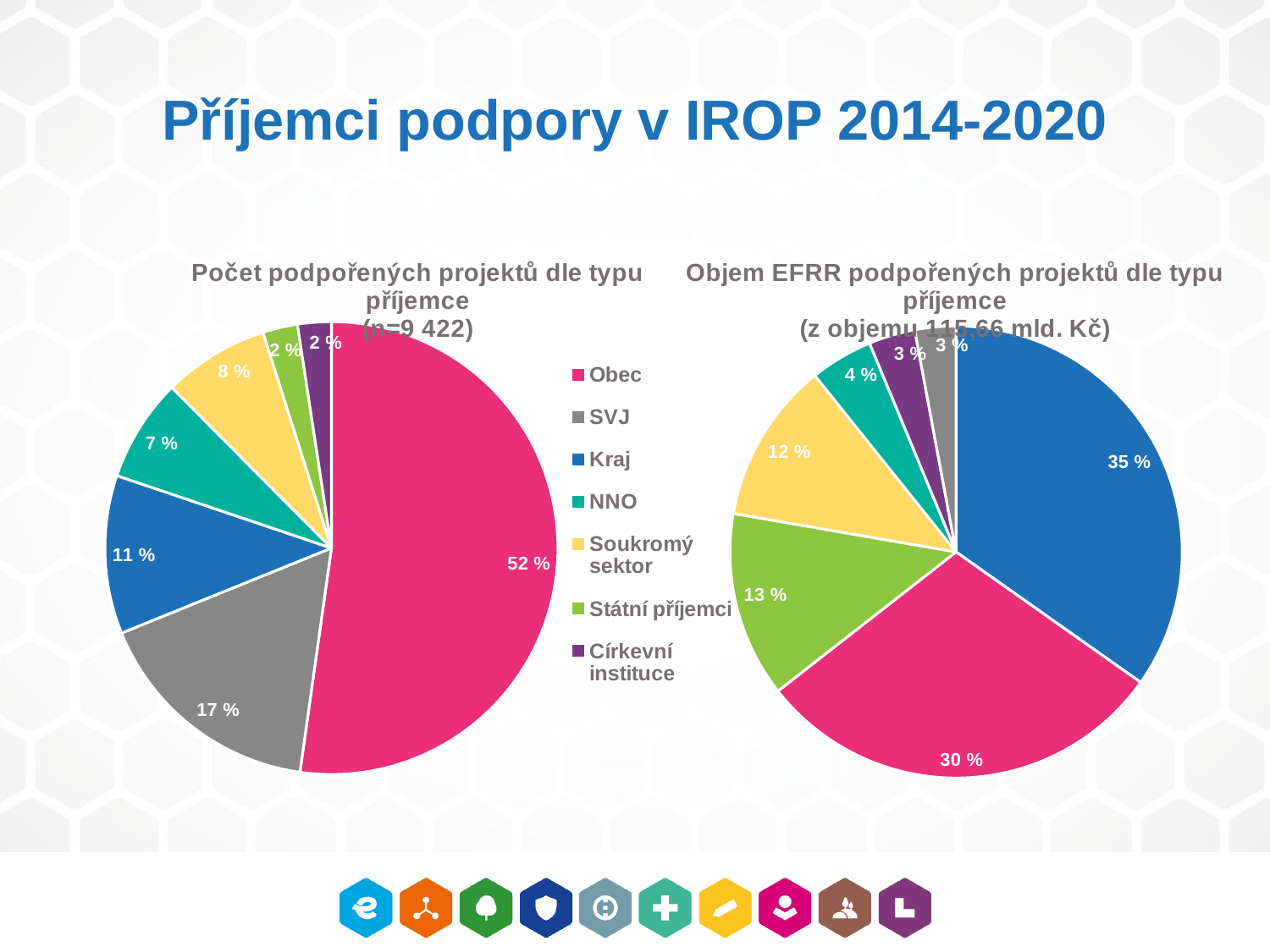
In the left pie chart (Počet podpořených projektů dle typu příjemce), what is the difference between the shares of Obec and SVJ? 35 % In the right pie chart (Objem EFRR podpořených projektů dle typu příjemce), what is the difference between the shares of Kraj and Obec? 5 % In the right pie chart (Objem EFRR podpořených projektů dle typu příjemce), what share is shown for Státní příjemci? 13 % In the right pie chart (Objem EFRR podpořených projektů dle typu příjemce), what share is shown for Kraj? 35 % What is the title of the right chart? Objem EFRR podpořených projektů dle typu příjemce (z objemu 115,66 mld. Kč) In the right pie chart (Objem EFRR podpořených projektů dle typu příjemce), which recipient type has the largest share? Kraj In the left pie chart (Počet podpořených projektů dle typu příjemce), what share is shown for SVJ? 17 % In the left pie chart (Počet podpořených projektů dle typu příjemce), which recipient type has the largest share? Obec In the right pie chart (Objem EFRR podpořených projektů dle typu příjemce), which recipient type has the smallest share, NNO or Soukromý sektor? NNO In the left pie chart (Počet podpořených projektů dle typu příjemce), what share of projects is for Obec? 52 % What type of chart is used on this slide? Pie chart How many recipient types does the legend list? 7